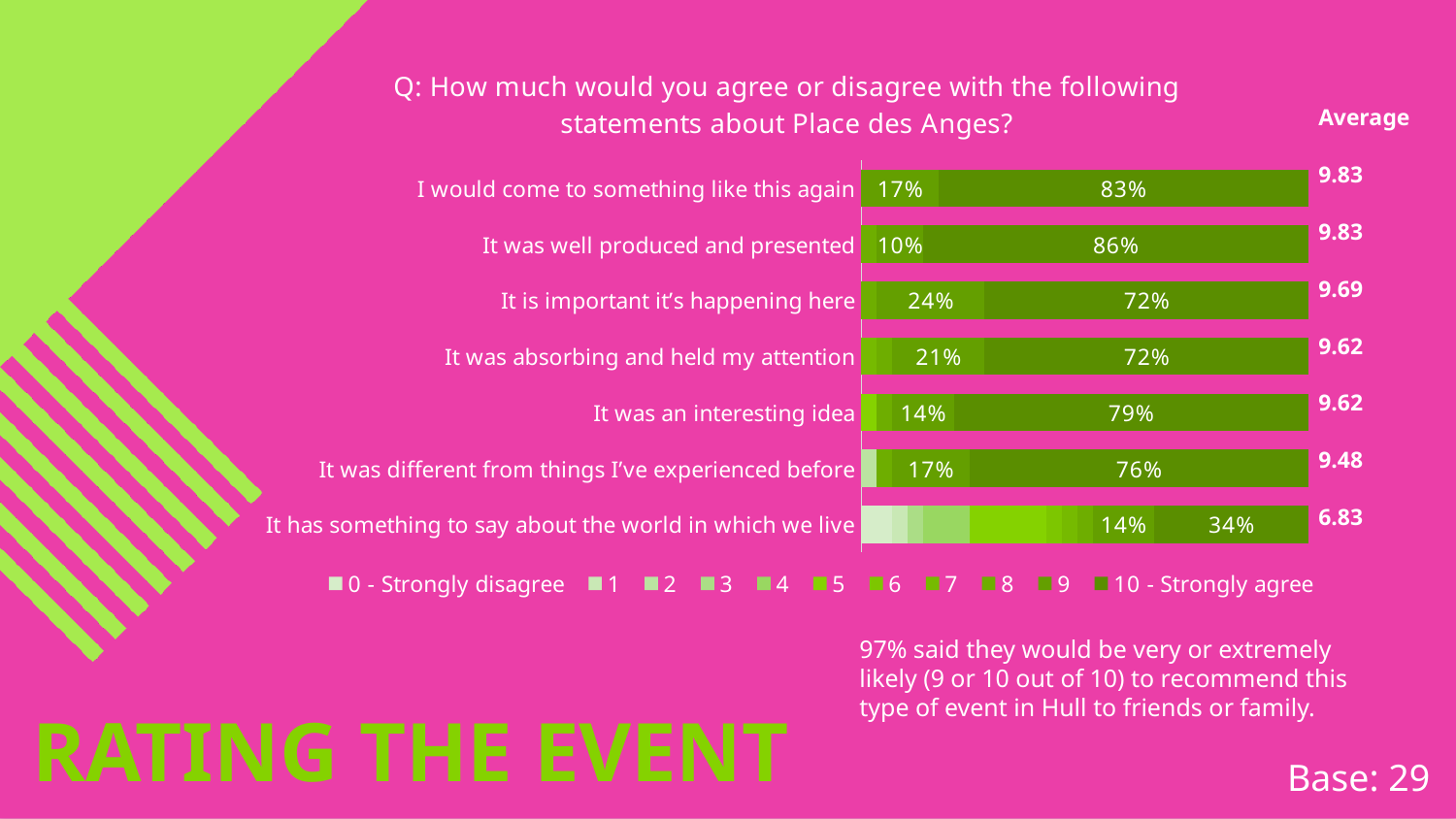
What percentage of respondents gave a rating of 10 - Strongly agree for "It has something to say about the world in which we live"? 34% What is the difference in percentage points between the 10 - Strongly agree share for "I would come to something like this again" and for "It was an interesting idea"? 4 percentage points How many series does the legend list? 11 Which statement has a larger share of 9 ratings: "It is important it's happening here" or "It was absorbing and held my attention"? It is important it's happening here What kind of chart is shown on the slide? Stacked bar chart What percentage of respondents gave a rating of 10 - Strongly agree for "I would come to something like this again"? 83% Which statement has the highest share of 10 - Strongly agree responses? It was well produced and presented What is the combined percentage of 9 and 10 ratings for "It was well produced and presented"? 96% What is the average score shown for "It was different from things I've experienced before"? 9.48 How many statements are shown in the chart? 7 What percentage of respondents gave a rating of 9 for "It was well produced and presented"? 10% Which statement has the lowest share of 10 - Strongly agree responses? It has something to say about the world in which we live